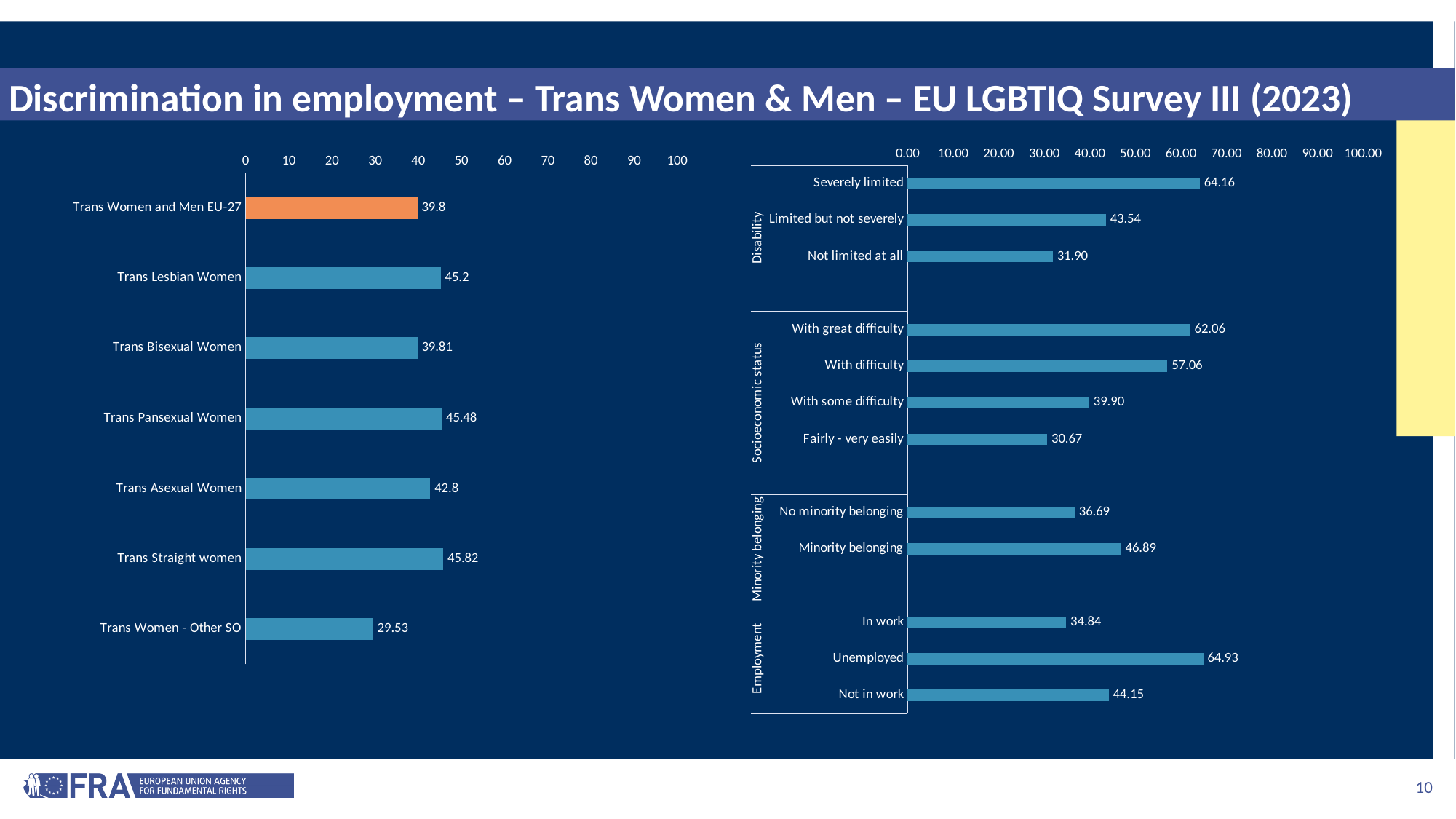
In the left chart, how many categories are shown? 7 In the left chart, what is the value for Trans Asexual Women? 42.8 In the left chart, what is the difference between Trans Lesbian Women and Trans Women - Other SO? 15.67 In the left chart, which category has the highest value? Trans Straight women In the left chart, what is the value for Trans Women and Men EU-27? 39.8 In the left chart, which category has the lowest value? Trans Women - Other SO In the right chart, what is the difference between With great difficulty and Fairly - very easily? 31.39 In the right chart, what is the value for Not limited at all? 31.90 What type of chart is the right chart? Bar chart In the left chart, which bar is coloured orange rather than blue? Trans Women and Men EU-27 In the right chart, what is the value for Unemployed? 64.93 In the right chart, which is larger: Minority belonging or No minority belonging? Minority belonging